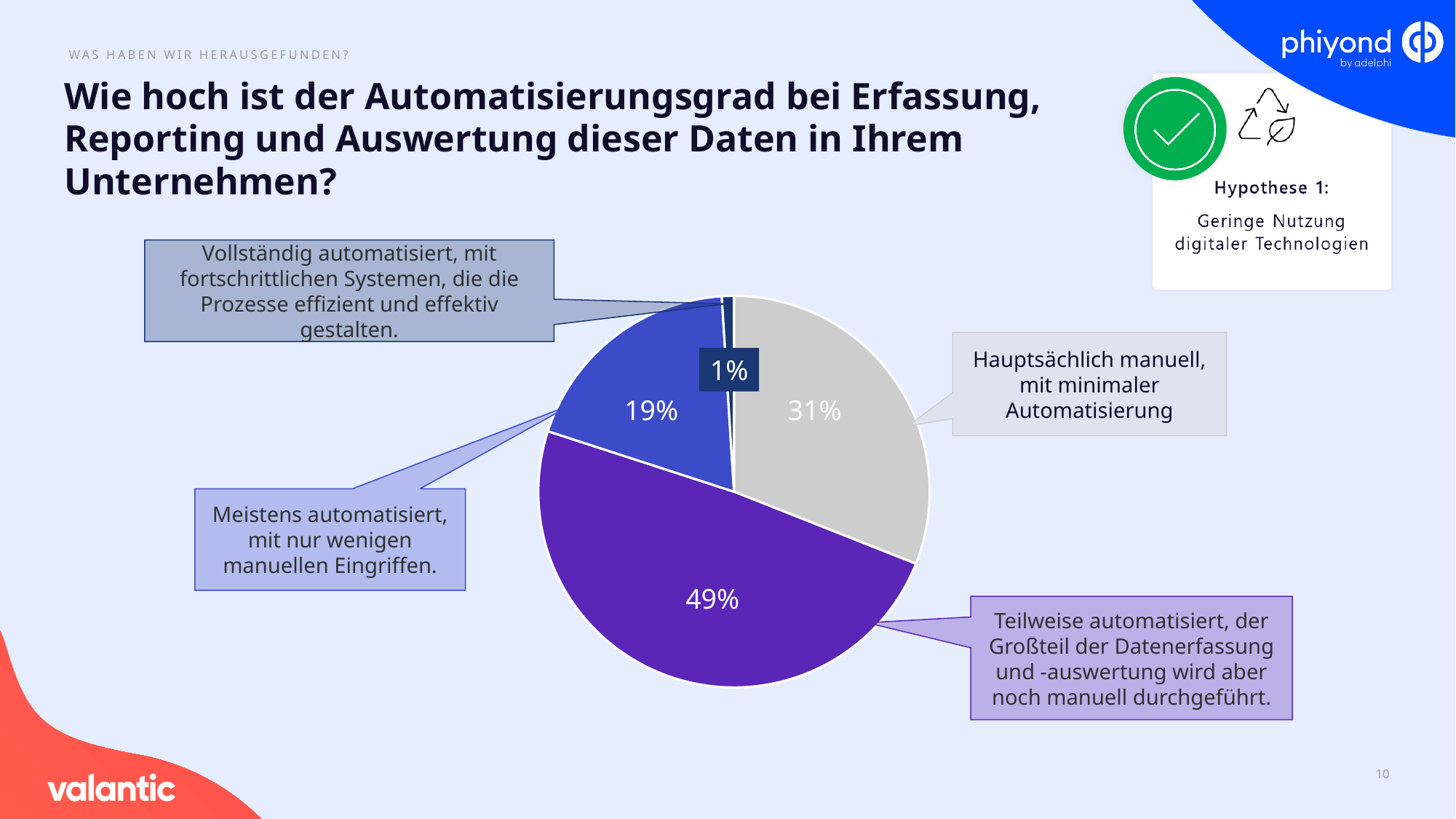
What share of the pie is labelled "Vollständig automatisiert, mit fortschrittlichen Systemen, die die Prozesse effizient und effektiv gestalten"? 1% Which category has the largest slice of the pie? Teilweise automatisiert, der Großteil der Datenerfassung und -auswertung wird aber noch manuell durchgeführt What is the difference in percentage points between the "Teilweise automatisiert" slice and the "Hauptsächlich manuell" slice? 18 What kind of chart is shown on the slide? pie chart Which is larger: the "Hauptsächlich manuell, mit minimaler Automatisierung" slice or the "Meistens automatisiert, mit nur wenigen manuellen Eingriffen" slice? Hauptsächlich manuell, mit minimaler Automatisierung What share of the pie is labelled "Meistens automatisiert, mit nur wenigen manuellen Eingriffen"? 19% What share of the pie is labelled "Hauptsächlich manuell, mit minimaler Automatisierung"? 31% What colour is the slice labelled 49%? purple Which category has the smallest slice of the pie? Vollständig automatisiert, mit fortschrittlichen Systemen, die die Prozesse effizient und effektiv gestalten What is the difference in percentage points between the "Meistens automatisiert" slice and the "Vollständig automatisiert" slice? 18 How many slices does the pie chart have? 4 What share of the pie is labelled "Teilweise automatisiert, der Großteil der Datenerfassung und -auswertung wird aber noch manuell durchgeführt"? 49%